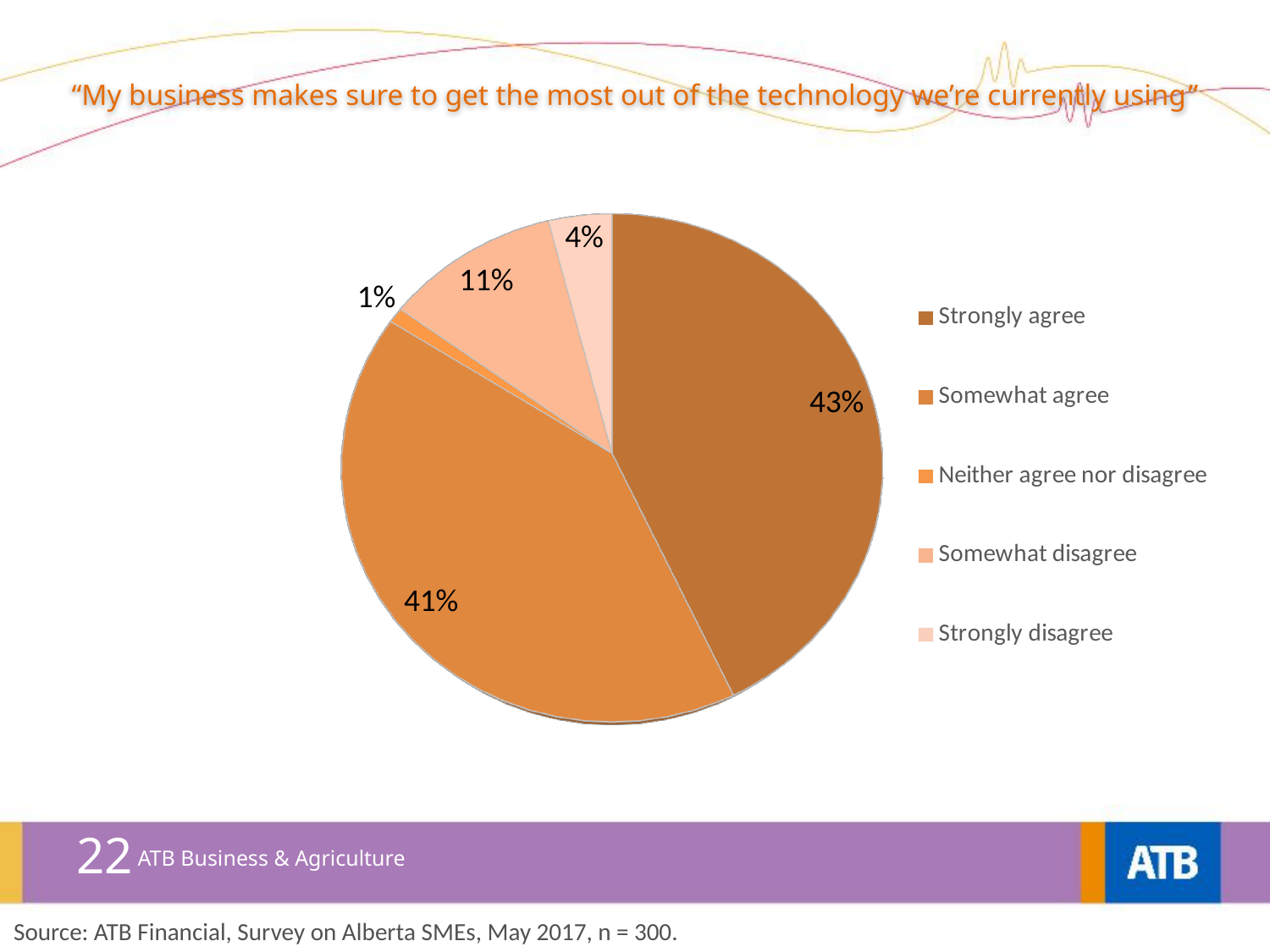
How many response categories does the legend list? 5 What percentage of respondents strongly agree? 43% What percentage of respondents somewhat disagree? 11% Which response category has the largest share of the pie? Strongly agree What percentage of respondents neither agree nor disagree? 1% What percentage of respondents strongly disagree? 4% What kind of chart is shown on the slide? Pie chart What is the difference in percentage points between Somewhat disagree and Strongly disagree? 7 Which response category has the smallest share of the pie? Neither agree nor disagree What percentage of respondents somewhat agree? 41% What is the combined share of Strongly agree and Somewhat agree? 84% Which is larger, the share for Somewhat agree or the share for Somewhat disagree? Somewhat agree